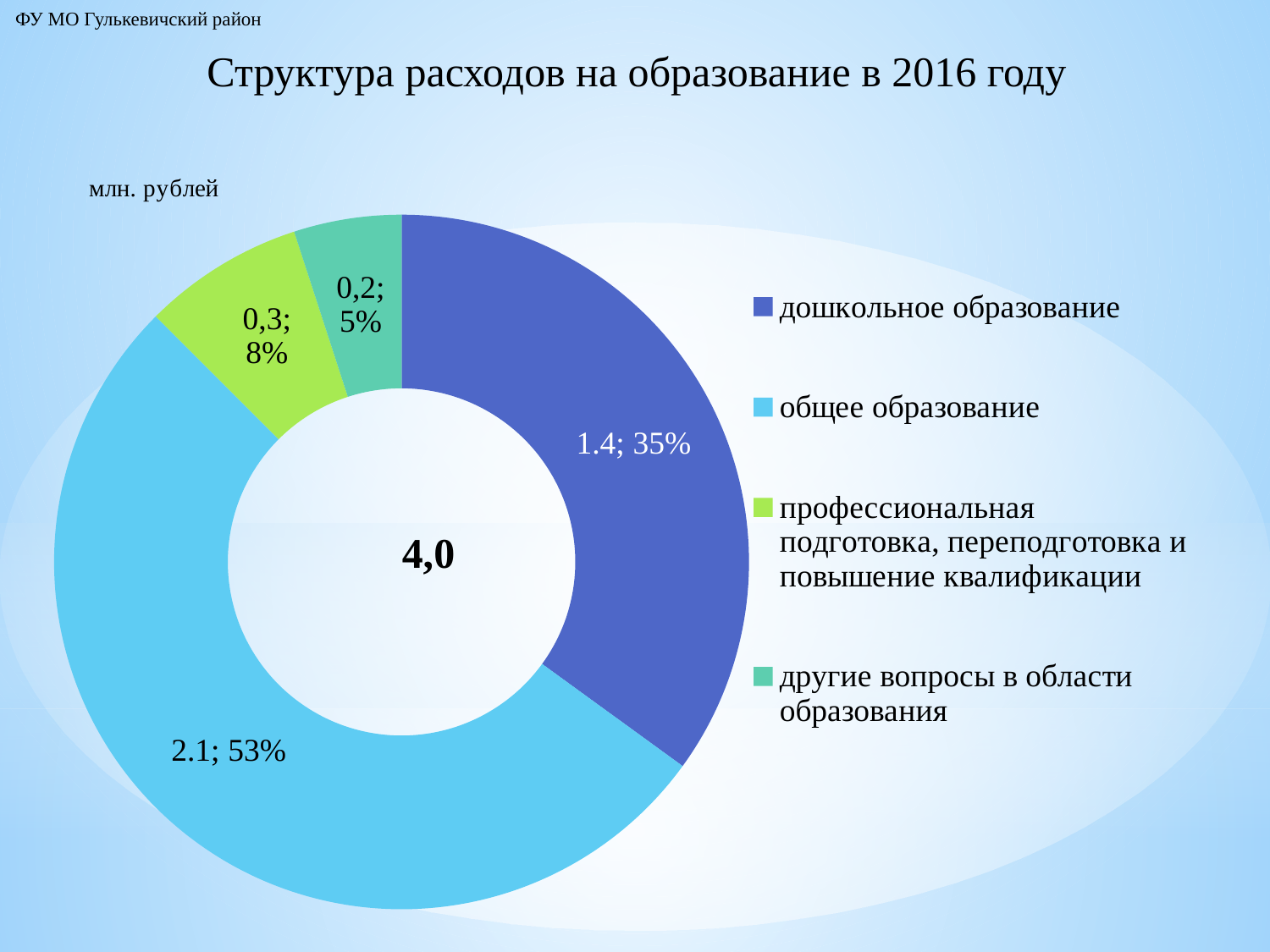
How many categories does the chart show? 4 What percentage share is shown for другие вопросы в области образования? 5% Which is larger, the value for дошкольное образование or the value for общее образование? общее образование What percentage share is shown for дошкольное образование? 35% Which category has the smallest share of the chart? другие вопросы в области образования What kind of chart is shown on the slide? doughnut (pie) chart What unit is indicated for the values on the chart? млн. рублей Which category has the largest share of the chart? общее образование What is the value shown for общее образование? 2.1 What is the value shown for профессиональная подготовка, переподготовка и повышение квалификации? 0,3 What total value is printed in the centre of the chart? 4,0 What is the difference between the value for общее образование and the value for дошкольное образование? 0.7